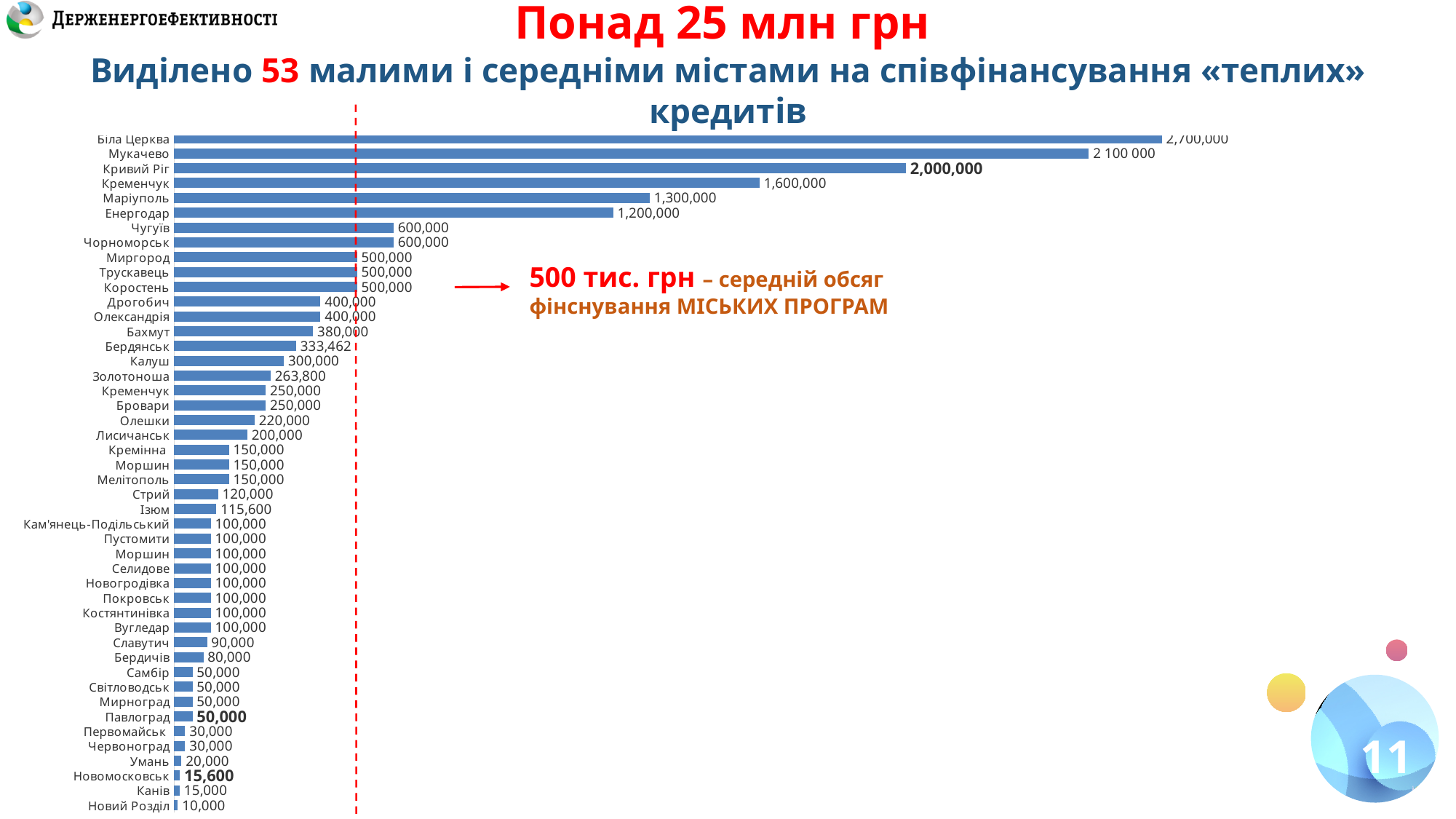
What is the value for Енергодар? 1,200,000 According to the annotation next to the dashed red line, what is the average amount of funding for city programmes? 500 тис. грн What is the value for Новомосковськ? 15,600 Which city has the lowest value in the chart? Новий Розділ Which city has the highest value in the chart? Біла Церква What is the value for Мукачево? 2 100 000 What kind of chart is shown on the slide? bar chart Which is larger, the value for Маріуполь or the value for Енергодар? Маріуполь What is the value for Золотоноша? 263,800 What is the value for Бердянськ? 333,462 What is the difference between the values for Бердянськ and Калуш? 33,462 What is the difference between the values for Мукачево and Кривий Ріг? 100,000